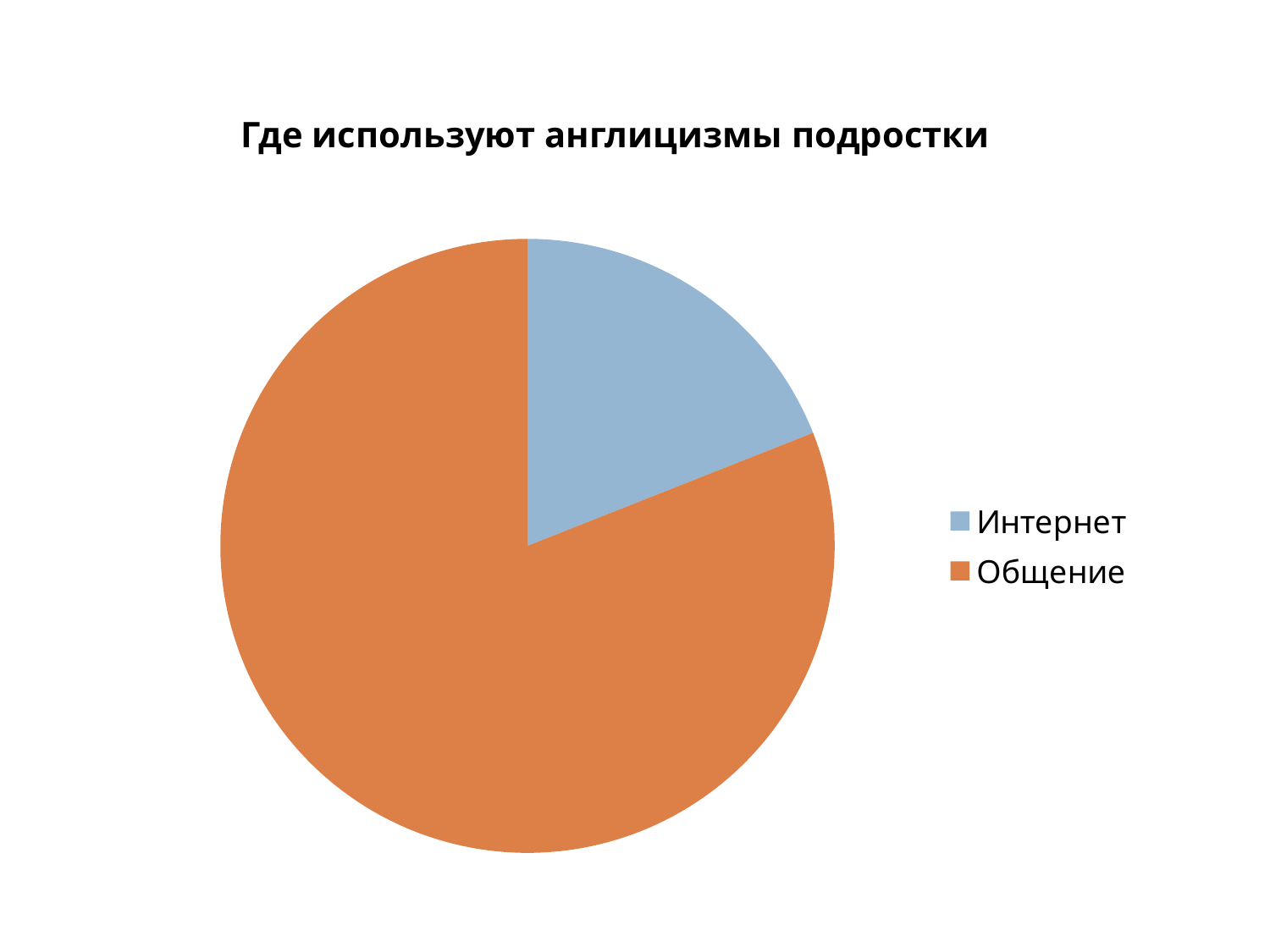
Is the share of the pie for Общение greater or less than 50%? greater What is the title of the chart? Где используют англицизмы подростки What kind of chart is shown on the slide? pie chart Is the share of the pie for Интернет greater or less than 50%? less Which category has the smallest slice of the pie? Интернет Which slice is larger, Интернет or Общение? Общение What colour is the slice for Общение? orange How many entries does the legend list? 2 How many categories does the pie chart have? 2 Which category has the largest slice of the pie? Общение